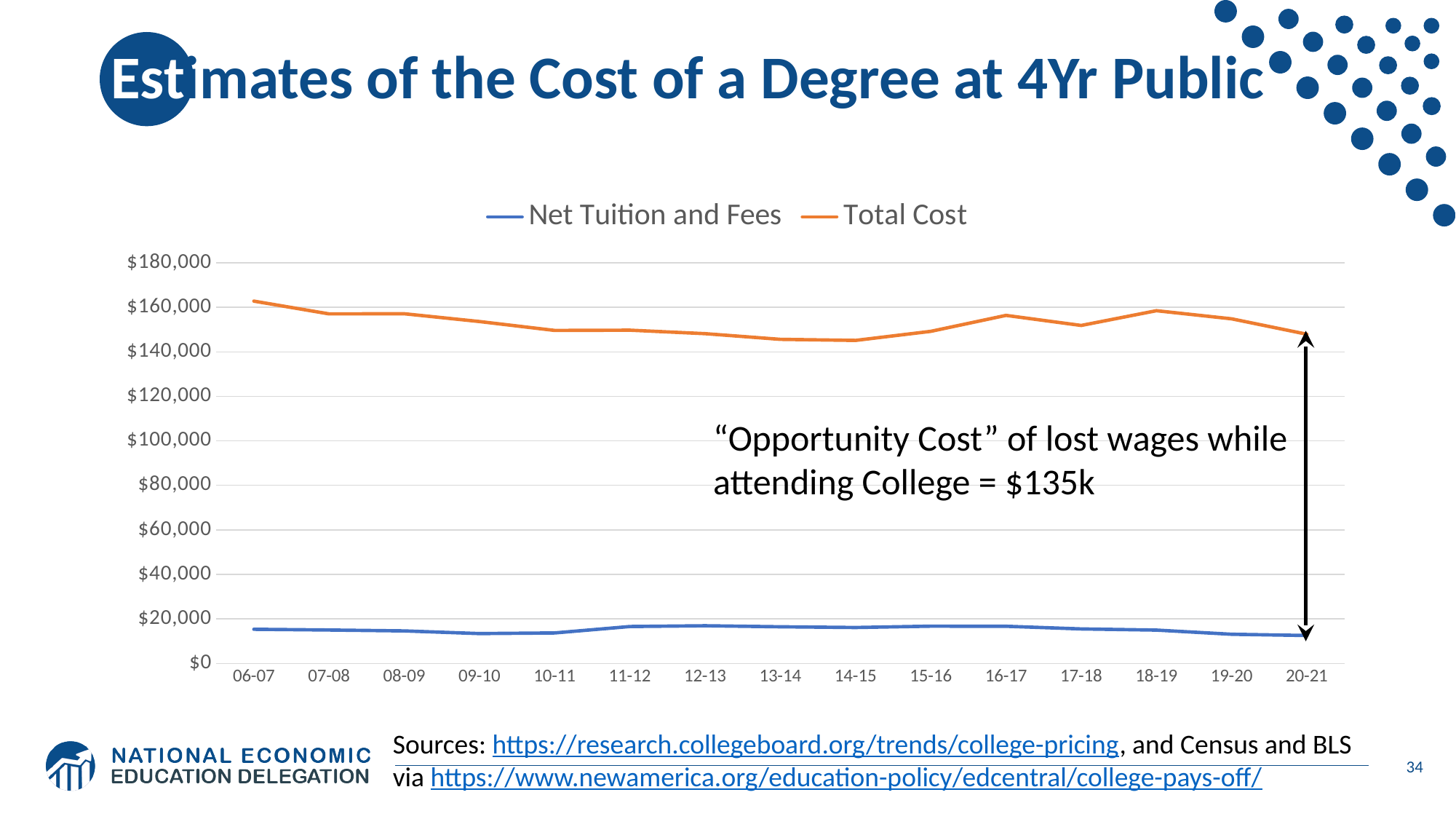
In which academic year is Total Cost at its highest? 06-07 In 06-07, which is larger: Total Cost or Net Tuition and Fees? Total Cost How many academic years are plotted along the x axis? 15 Which series is drawn in orange? Total Cost Is the Net Tuition and Fees value for 11-12 greater or less than $40,000? less How many series does the legend list? 2 What kind of chart is shown on the slide? Line chart According to the annotation on the chart, what is the "Opportunity Cost" of lost wages while attending college? $135k Is the Total Cost value for 14-15 greater or less than $160,000? less Does Total Cost rise or fall from 06-07 to 10-11? Fall Is the Total Cost value for 06-07 greater or less than $140,000? greater